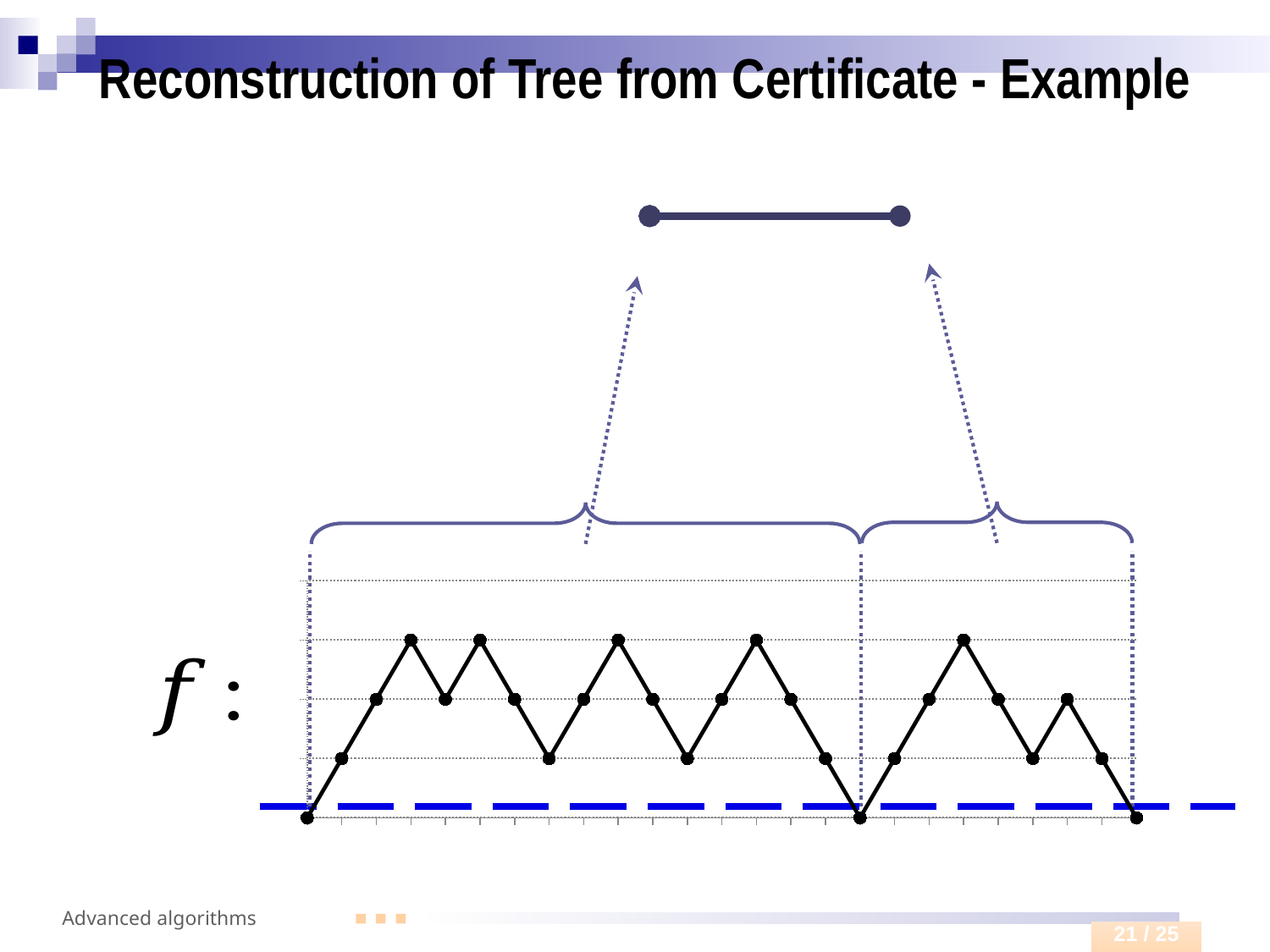
What label appears to the left of the chart? f : How many data points are plotted on the line? 25 How many times does the line touch the dashed blue baseline? 3 Does the line start and end at the same level? yes What is the title of the slide containing the chart? Reconstruction of Tree from Certificate - Example Does the line rise or fall over its first three steps from the left? rise What kind of chart is shown on the slide? line chart How many peaks reach the highest level of the line? 5